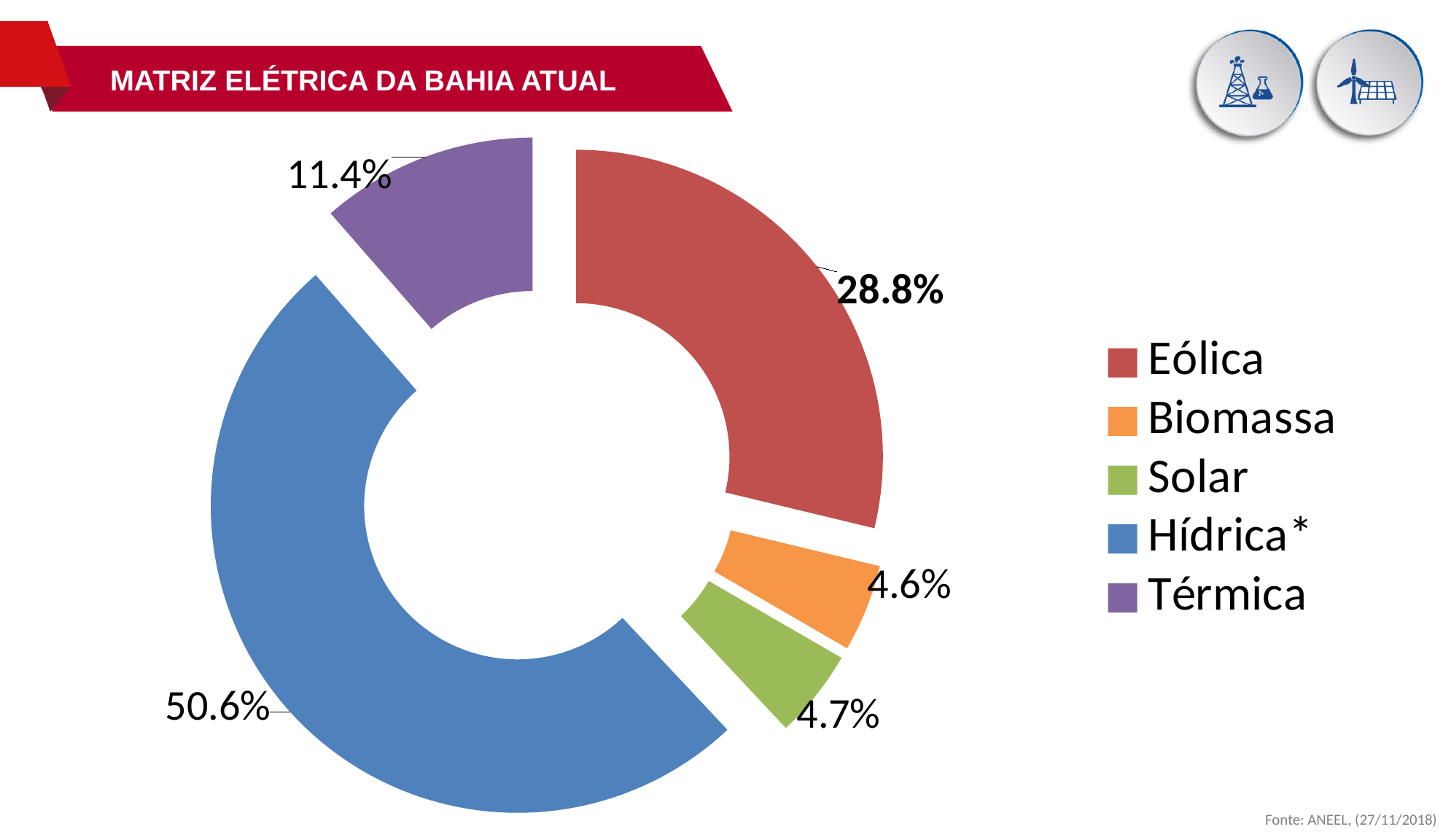
What percentage is shown for Térmica? 11.4% Which category has the smallest share of the chart? Biomassa What is the value shown for Eólica? 28.8% What percentage does Hídrica* account for in the chart? 50.6% What is the value for Biomassa? 4.6% How many categories are shown in the chart? 5 What is the title of the slide containing the chart? MATRIZ ELÉTRICA DA BAHIA ATUAL Which is larger, Eólica or Térmica? Eólica What is the value for Solar? 4.7% What type of chart is shown on the slide? Doughnut (pie) chart Which category has the largest share of the chart? Hídrica* What is the difference between the Hídrica* and Eólica percentages? 21.8%